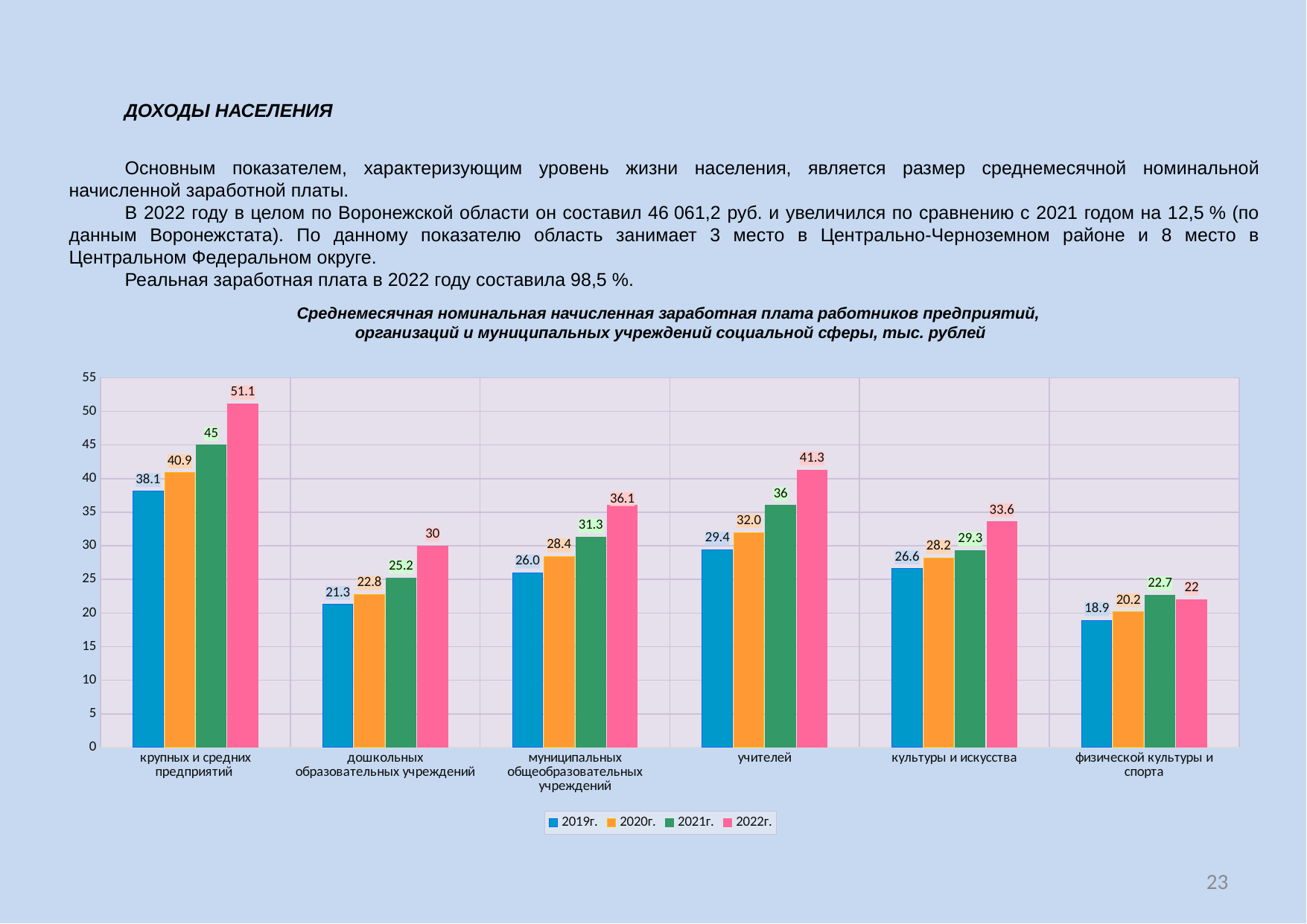
What is the value for культуры и искусства in 2021г.? 29.3 What is the difference between the 2022г. and 2019г. values for крупных и средних предприятий? 13.0 Which category has the highest value in 2022г.? крупных и средних предприятий How many series does the legend list? 4 What is the value for учителей in 2022г.? 41.3 Which is larger for физической культуры и спорта: the 2021г. value or the 2022г. value? 2021г. Which category has the lowest value in 2019г.? физической культуры и спорта How many categories are shown on the x axis? 6 Which series is shown in pink in the legend? 2022г. Do the values for учителей rise or fall from 2019г. to 2022г.? rise What is the value for дошкольных образовательных учреждений in 2019г.? 21.3 What type of chart is shown on the slide? bar chart